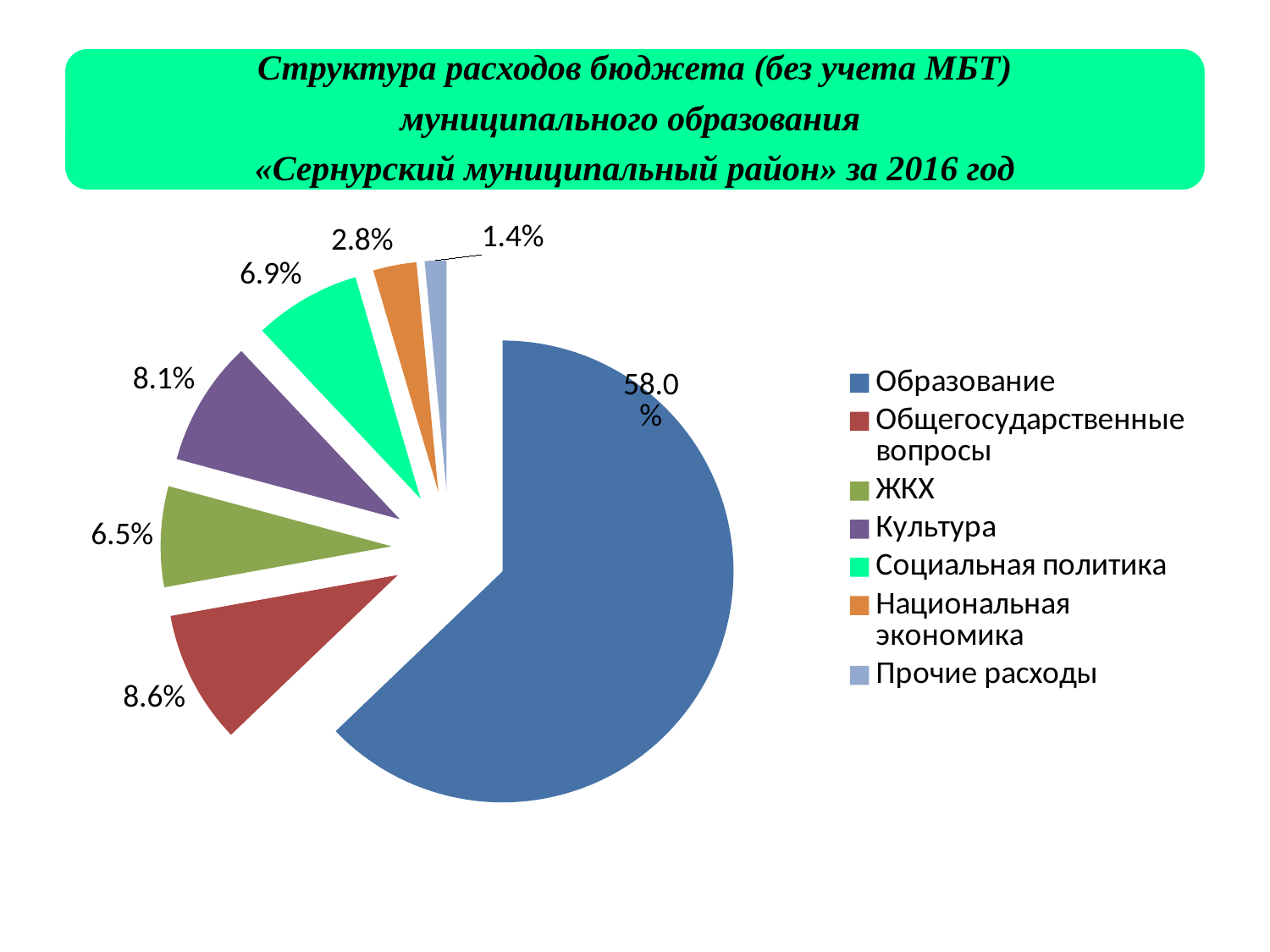
Which category has the smallest slice of the pie? Прочие расходы What is the value shown for Социальная политика? 6.9% What is the value shown for ЖКХ? 6.5% What is the value shown for Культура? 8.1% Which category has the largest slice of the pie? Образование What is the value shown for Общегосударственные вопросы? 8.6% What is the value shown for Прочие расходы? 1.4% What share of the pie does Образование account for? 58.0% What kind of chart is shown on the slide? Pie chart Which is larger, the share for Культура or the share for Социальная политика? Культура What is the difference between the shares of Общегосударственные вопросы and Национальная экономика? 5.8% How many categories does the legend list? 7